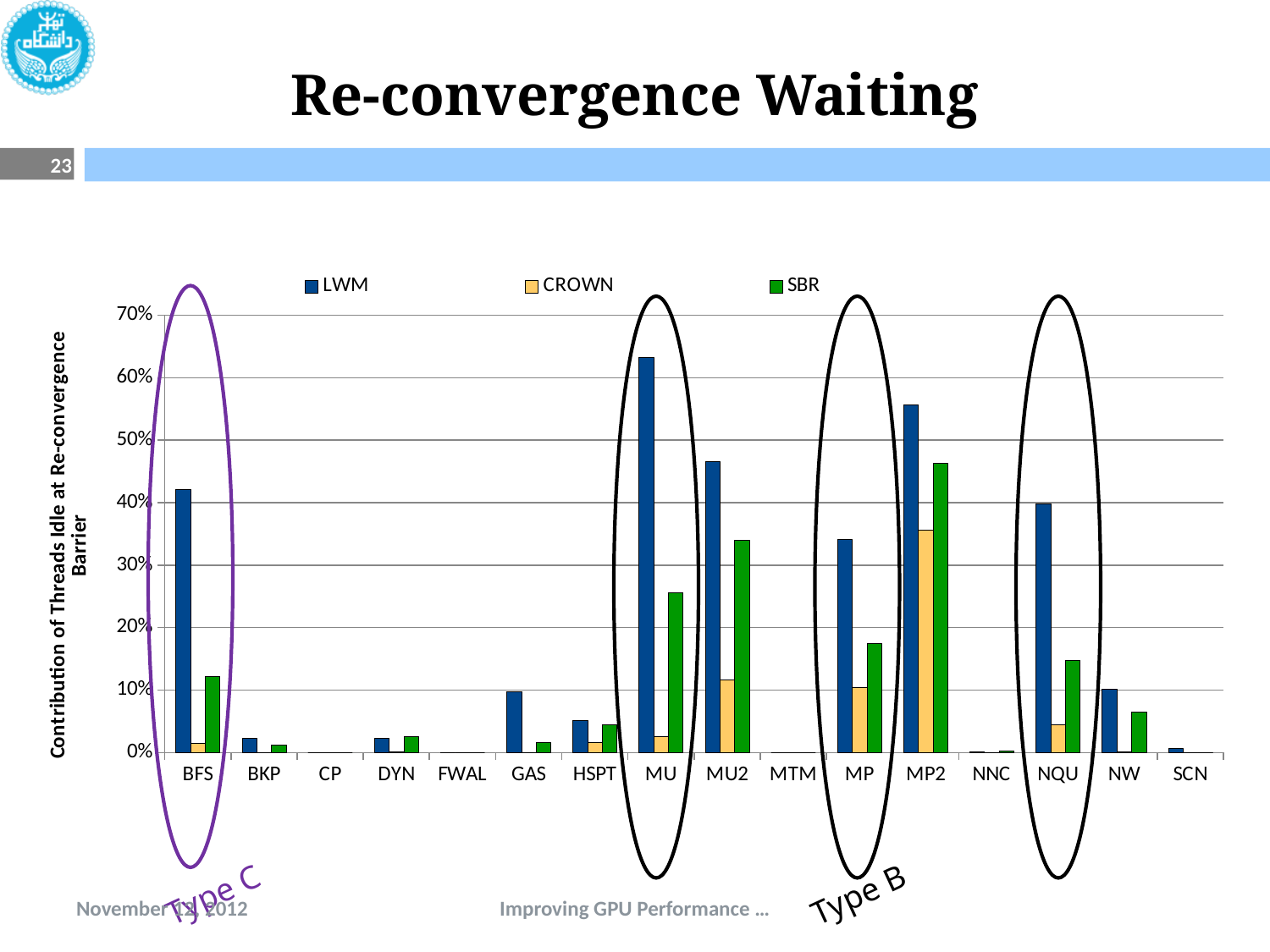
Which category has the highest SBR value? MP2 How many series does the legend list? 3 What kind of chart is shown on the slide? bar chart For MP, which is larger, the CROWN value or the SBR value? SBR What is the title of the y axis? Contribution of Threads Idle at Re-convergence Barrier How many benchmark categories are shown along the x axis? 16 Which category has the highest CROWN value? MP2 Is the SBR value for NQU greater or less than 20%? less Which category has the highest LWM value? MU For MU2, which is larger, the LWM value or the SBR value? LWM Is the LWM value for MU greater or less than 60%? greater Is the LWM value for BFS greater or less than 40%? greater